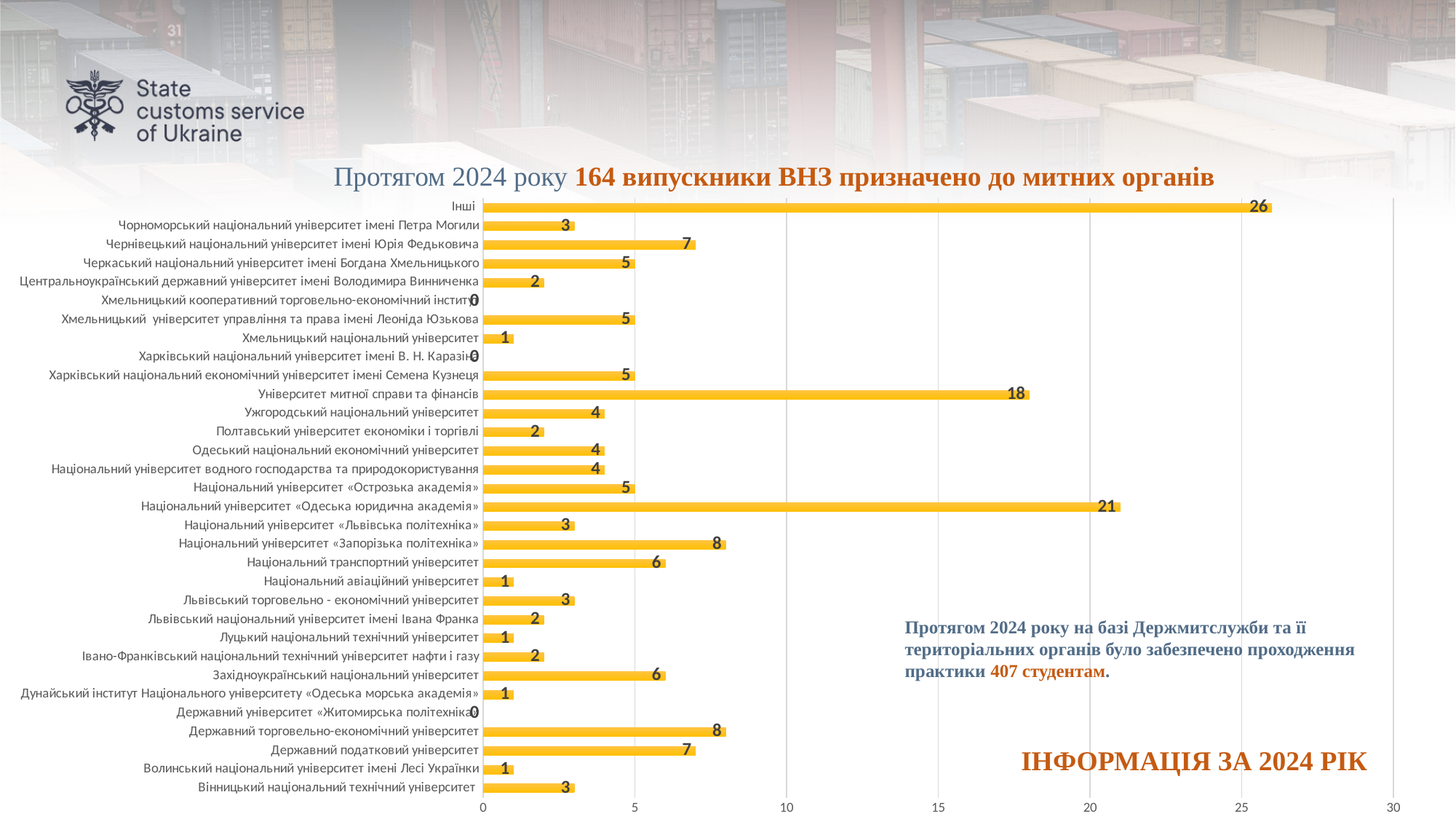
Which has a larger value: Чернівецький національний університет імені Юрія Федьковича or Черкаський національний університет імені Богдана Хмельницького? Чернівецький національний університет імені Юрія Федьковича Which category has the highest value in the chart? Інші How many categories are shown in the chart? 32 How many graduates does the chart show for Університет митної справи та фінансів? 18 What is the value for Національний університет «Запорізька політехніка»? 8 What is the difference between the values for Національний транспортний університет and Національний авіаційний університет? 5 What is the value for Державний податковий університет? 7 What is the value for Національний університет «Одеська юридична академія»? 21 What is the difference between the values for Інші and Національний університет «Одеська юридична академія»? 5 What type of chart is shown on the slide? bar chart Is the value for Університет митної справи та фінансів greater or less than 15? greater What is the highest value shown on the horizontal axis of the chart? 30